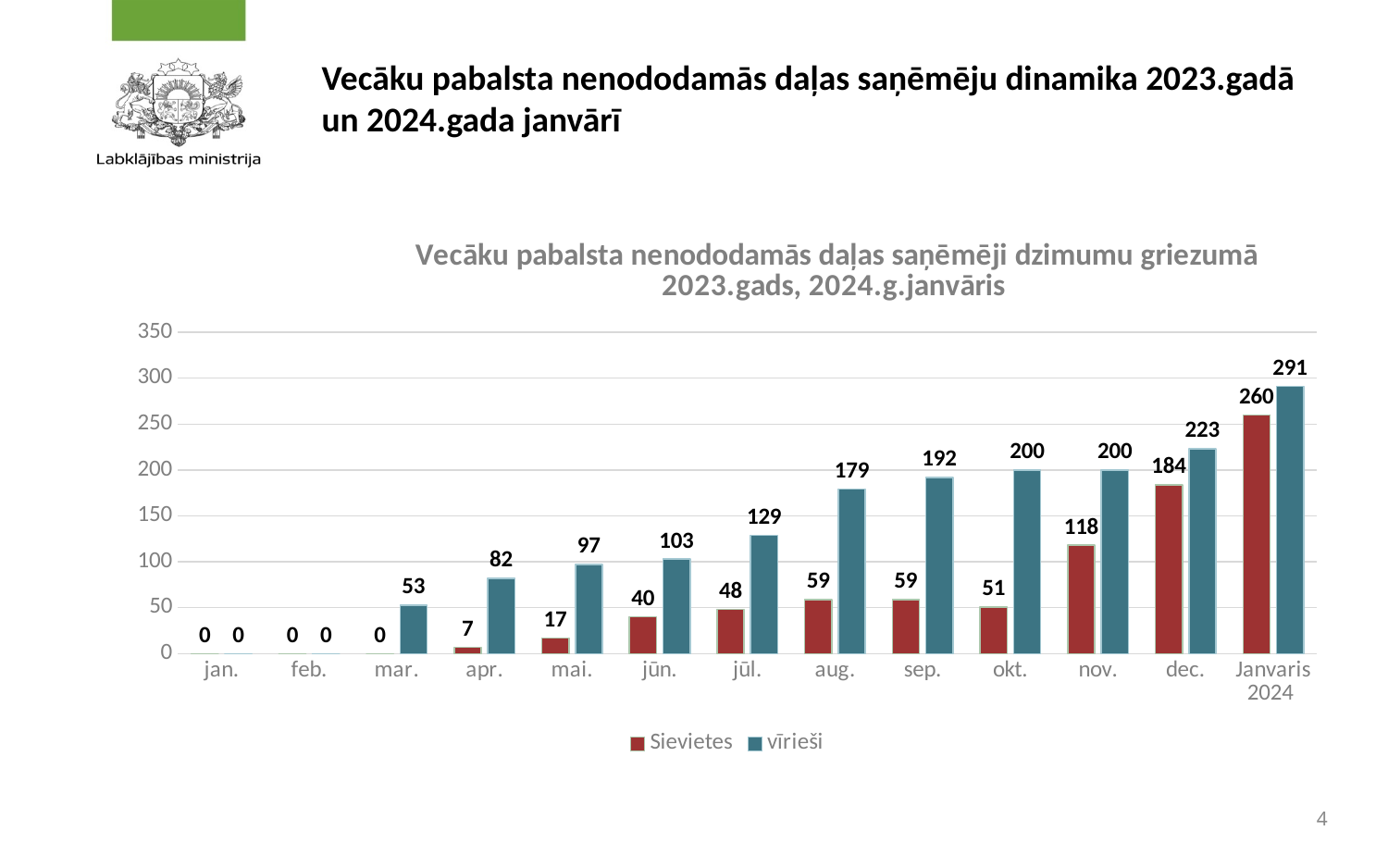
In which month is the Sievietes value highest? Janvaris 2024 What is the value for Sievietes in nov.? 118 What is the difference between the vīrieši and Sievietes values in aug.? 120 What is the value for Sievietes in apr.? 7 How many months (categories) are shown on the x axis? 13 Which series is shown in red? Sievietes Do the vīrieši values generally rise or fall from jan. to Janvaris 2024? rise What is the value for vīrieši in dec.? 223 What kind of chart is shown on the slide? bar chart How many series does the legend list? 2 Which is larger in okt., the Sievietes value or the vīrieši value? vīrieši What is the value for vīrieši in Janvaris 2024? 291